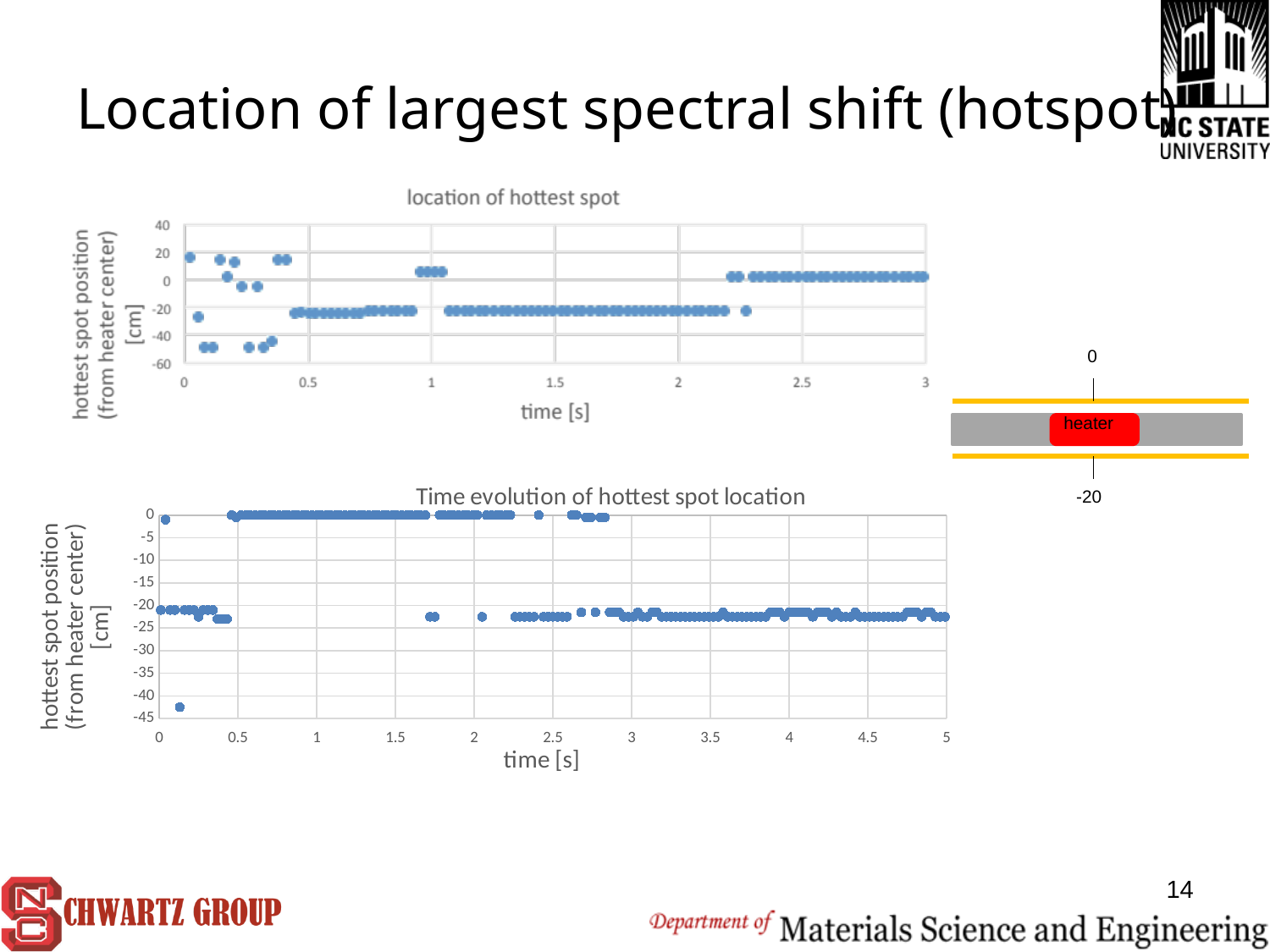
How many charts are shown on the slide? 2 In the bottom chart 'Time evolution of hottest spot location', is the lowest plotted point greater or less than -40? less In the top chart 'location of hottest spot', is the hottest spot position at time 0.7 s greater or less than 0? less In the top chart 'location of hottest spot', is the hottest spot position at time 1.5 s greater or less than 0? less What kind of chart is the bottom chart titled 'Time evolution of hottest spot location'? scatter chart What is the title of the top chart on the slide? location of hottest spot What kind of chart is the top chart titled 'location of hottest spot'? scatter chart What is the title of the bottom chart on the slide? Time evolution of hottest spot location